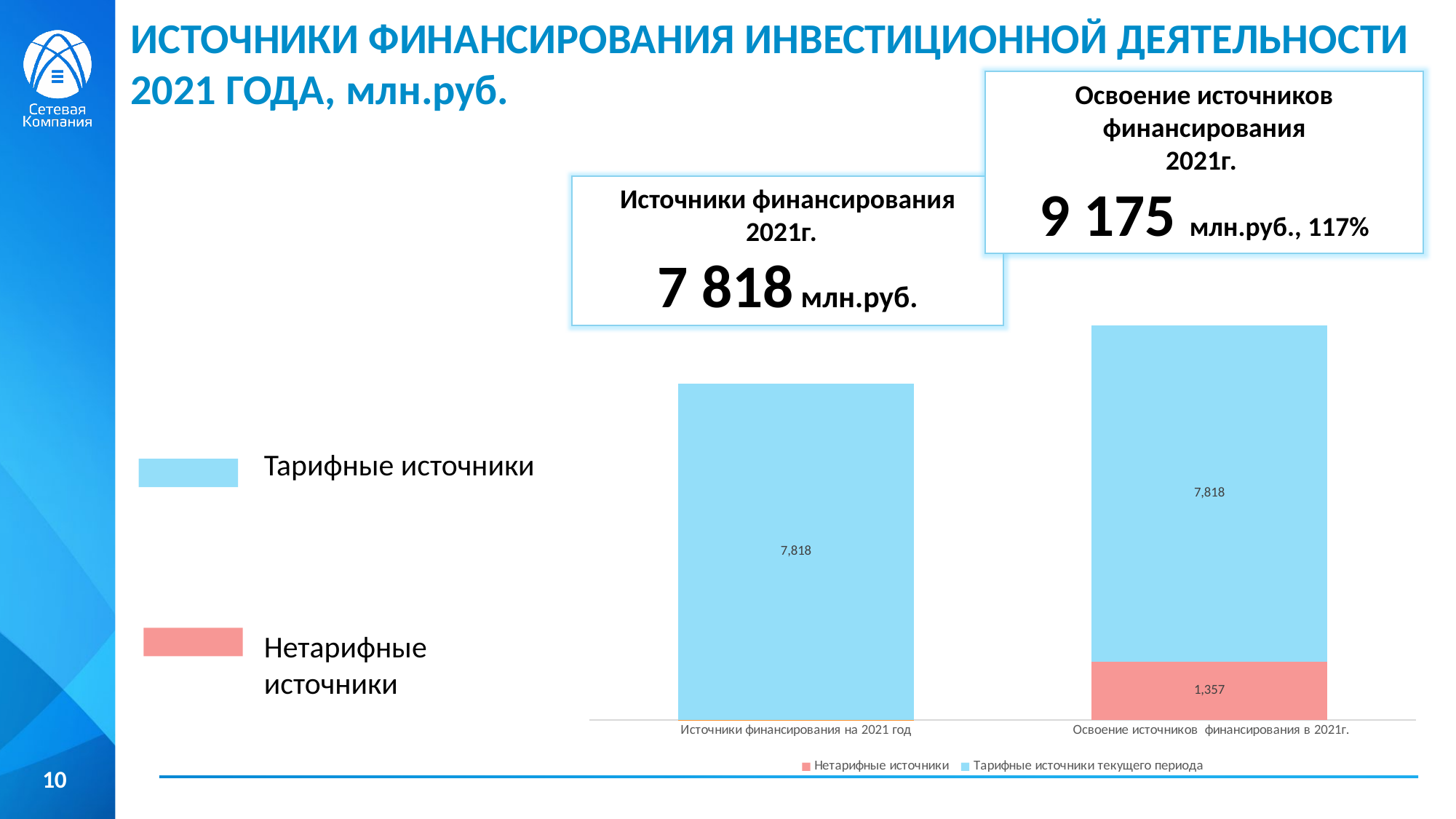
What is the value of Тарифные источники текущего периода for Освоение источников финансирования в 2021г.? 7,818 Which is larger in the Освоение источников финансирования в 2021г. bar: Тарифные источники текущего периода or Нетарифные источники? Тарифные источники текущего периода What kind of chart is shown on the slide? stacked bar chart Which category has the taller stacked bar overall? Освоение источников финансирования в 2021г. How many series does the chart legend list? 2 What is the value of Нетарифные источники for Освоение источников финансирования в 2021г.? 1,357 What is the difference between the Тарифные источники текущего периода value and the Нетарифные источники value in the Освоение источников финансирования в 2021г. bar? 6,461 Which series is shown in red/pink in the chart legend? Нетарифные источники What is the total of the stacked bar for Освоение источников финансирования в 2021г.? 9,175 What is the value of Тарифные источники текущего периода for Источники финансирования на 2021 год? 7,818 How many categories are shown on the x axis of the chart? 2 Which category has no Нетарифные источники segment in its bar? Источники финансирования на 2021 год